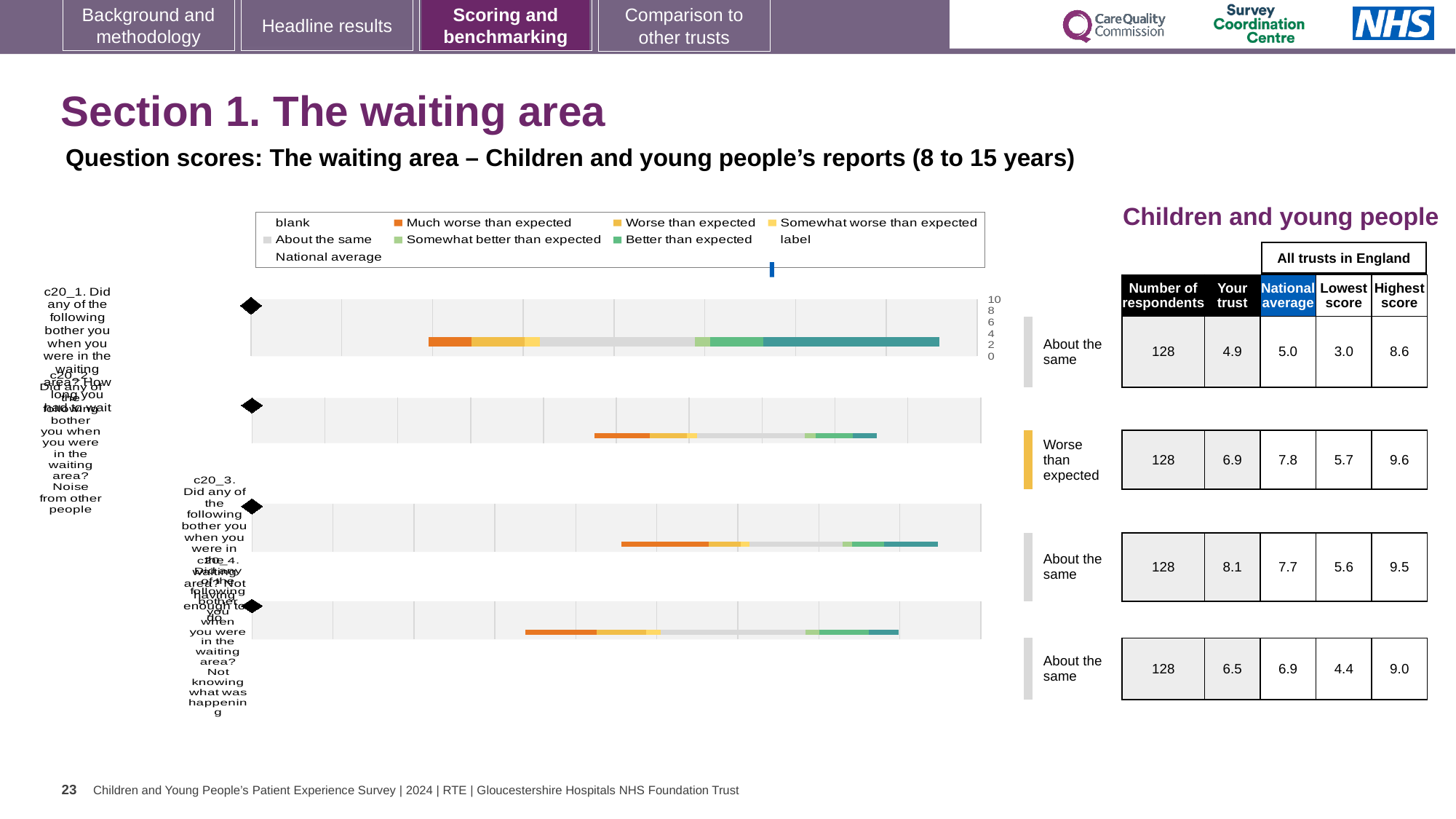
How many entries does the legend of the waiting area chart list? 9 In the table beside the chart, what is the 'Your trust' score for the second question (rated 'Worse than expected')? 6.9 What is the highest tick value shown on the chart's score axis? 10 In the table beside the chart, what is the national average for the second question (rated 'Worse than expected')? 7.8 In the table beside the chart, how many respondents answered the first question? 128 Which row in the table has the highest 'Your trust' score? the third question (8.1) Which row in the table has the lowest 'Your trust' score? the first question (4.9) How many question bars are plotted in the waiting area chart? 4 What kind of chart is used to show the question scores for the waiting area? bar chart For the second question, what is the difference between the national average (7.8) and the trust's score (6.9)? 0.9 In the table beside the chart, what is the highest score across all trusts in England for the third question? 9.5 What colour represents 'Much worse than expected' in the chart legend? orange